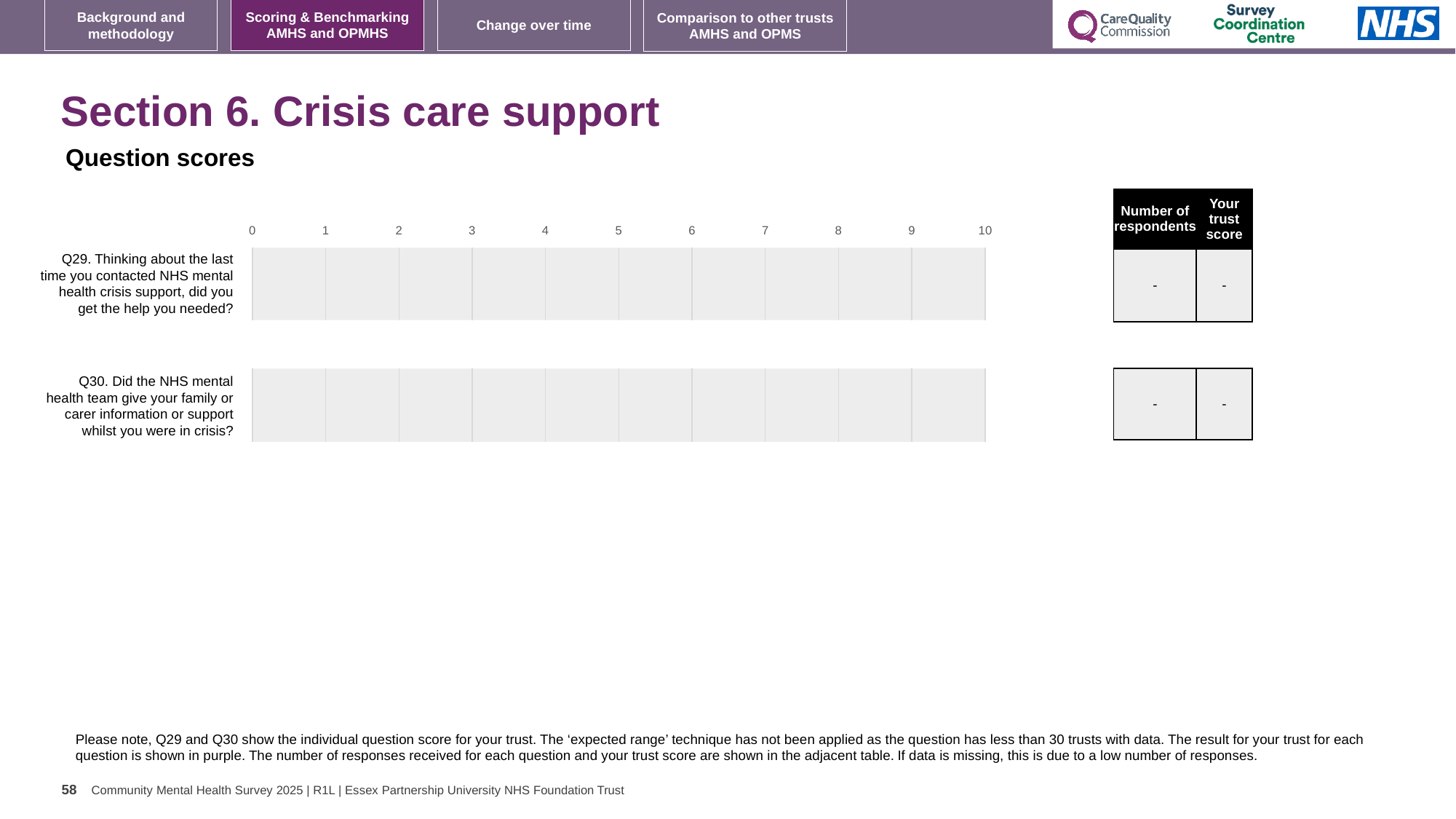
What value is shown in the 'Number of respondents' column for Q30? - Which question number is listed first (at the top) on the chart? Q29 What value is shown in the 'Your trust score' column for Q30? - What is the minimum value shown on the chart's horizontal axis? 0 What value is shown in the 'Number of respondents' column for Q29? - How many questions (categories) are listed on the chart's vertical axis? 2 What value is shown in the 'Your trust score' column for Q29? - What is the maximum value shown on the chart's horizontal axis? 10